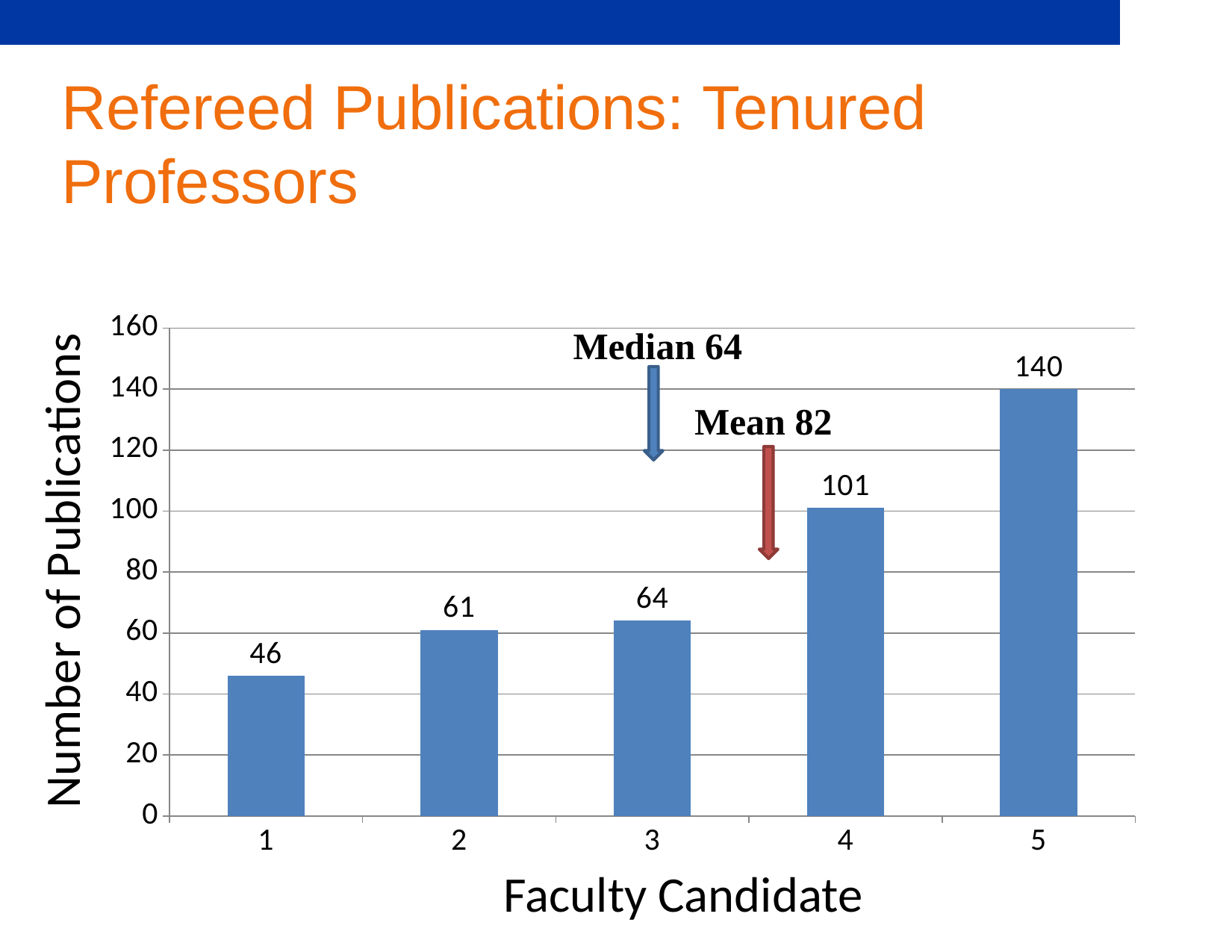
What median value is annotated on the chart? 64 Which faculty candidate has the lowest number of publications? 1 What is the number of publications for Faculty Candidate 4? 101 Who has more publications, Faculty Candidate 2 or Faculty Candidate 4? Faculty Candidate 4 What kind of chart is shown on the slide? Bar chart What is the difference in publications between Faculty Candidate 3 and Faculty Candidate 2? 3 How many faculty candidates are shown in the chart? 5 How many publications does Faculty Candidate 1 have? 46 Is the number of publications for Faculty Candidate 5 greater or less than 120? greater What is the difference in publications between Faculty Candidate 5 and Faculty Candidate 4? 39 Which faculty candidate has the highest number of publications? 5 Do the number of publications rise or fall from Faculty Candidate 1 to Faculty Candidate 5? Rise